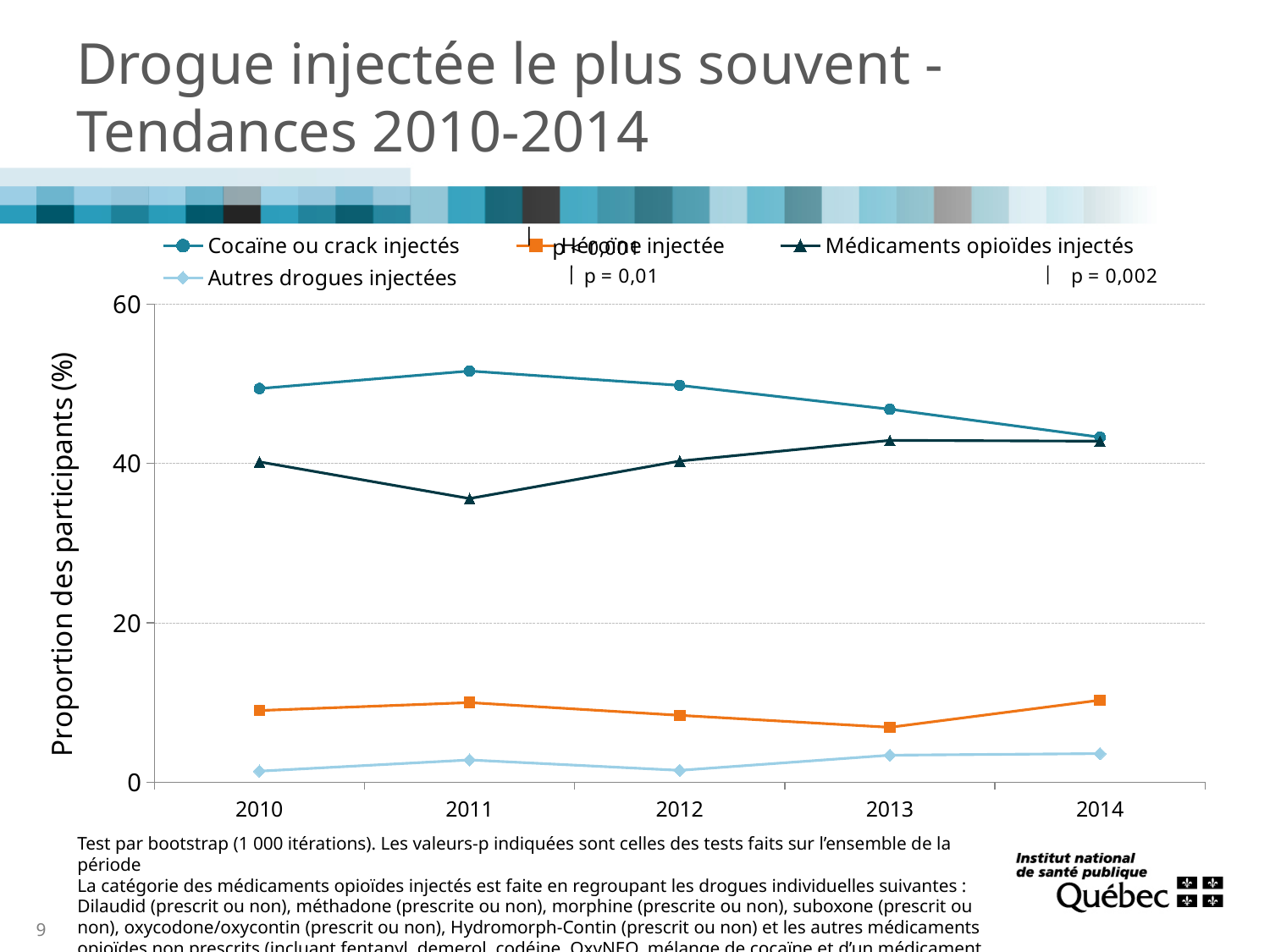
Does the value for Cocaïne ou crack injectés rise or fall from 2011 to 2014? fall How many years are plotted along the x axis? 5 Is the value for Héroïne injectée in 2013 greater or less than 20? less Which series has the lowest value in 2014? Autres drogues injectées Is the value for Cocaïne ou crack injectés in 2011 greater or less than 40? greater In which year is the value for Médicaments opioïdes injectés lowest? 2011 In 2012, which is larger: Cocaïne ou crack injectés or Médicaments opioïdes injectés? Cocaïne ou crack injectés What kind of chart is shown on the slide? line chart Which series has the highest value in 2010? Cocaïne ou crack injectés How many series does the legend list? 4 Is the value for Médicaments opioïdes injectés in 2011 greater or less than 40? less What is the label of the y axis? Proportion des participants (%)